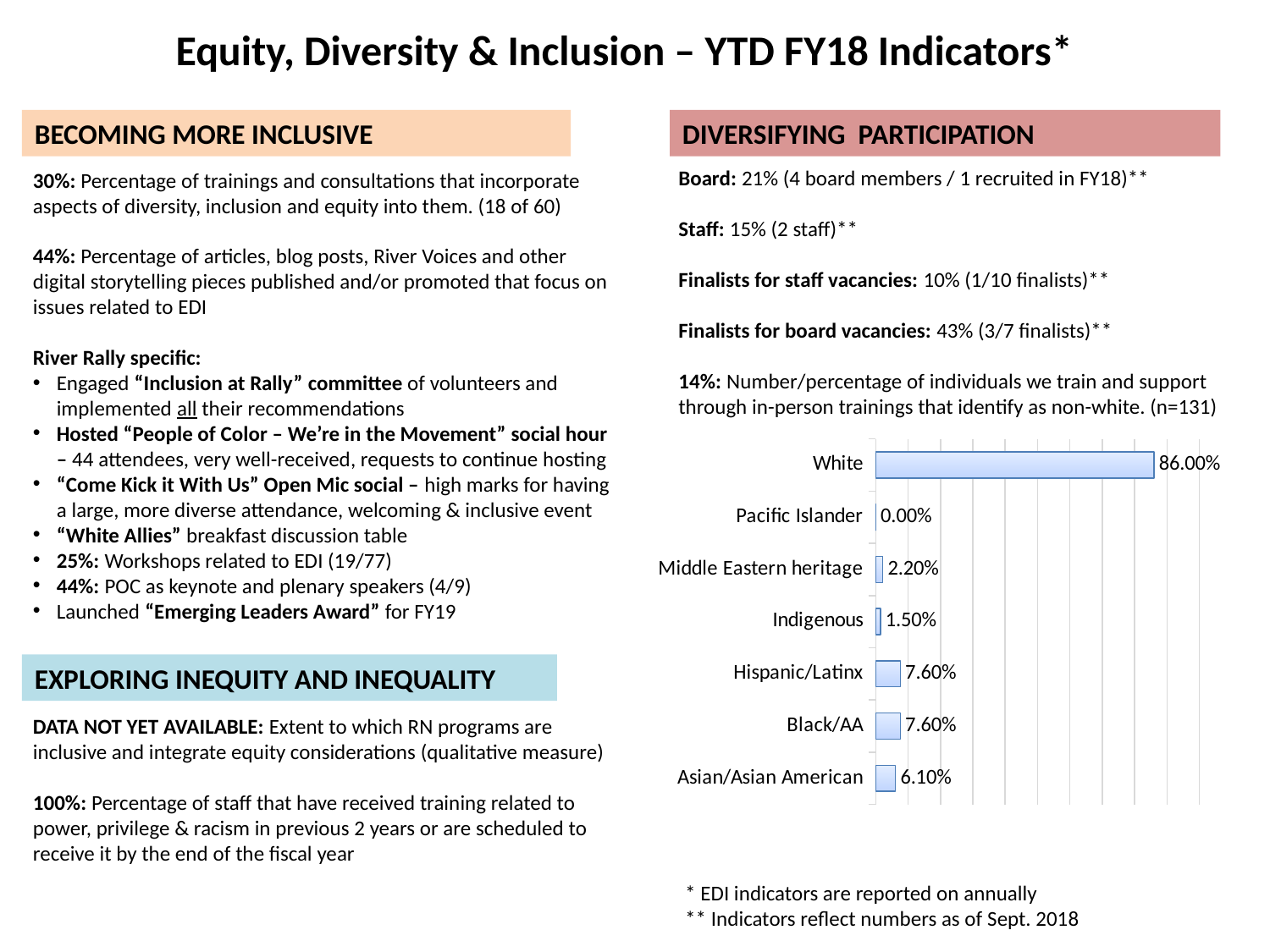
Which category has the highest value in the bar chart? White What is the value for White in the bar chart? 86.00% Which is larger in the bar chart, the value for Middle Eastern heritage or the value for Indigenous? Middle Eastern heritage What kind of chart is shown on the slide? Bar chart Which category has the lowest value in the bar chart? Pacific Islander What is the value for Middle Eastern heritage in the bar chart? 2.20% What is the value for Hispanic/Latinx in the bar chart? 7.60% What is the difference between the values for White and Hispanic/Latinx in the bar chart? 78.40% How many categories are shown in the bar chart? 7 What is the value for Indigenous in the bar chart? 1.50% What is the difference between the values for Black/AA and Asian/Asian American in the bar chart? 1.50% What is the value for Asian/Asian American in the bar chart? 6.10%